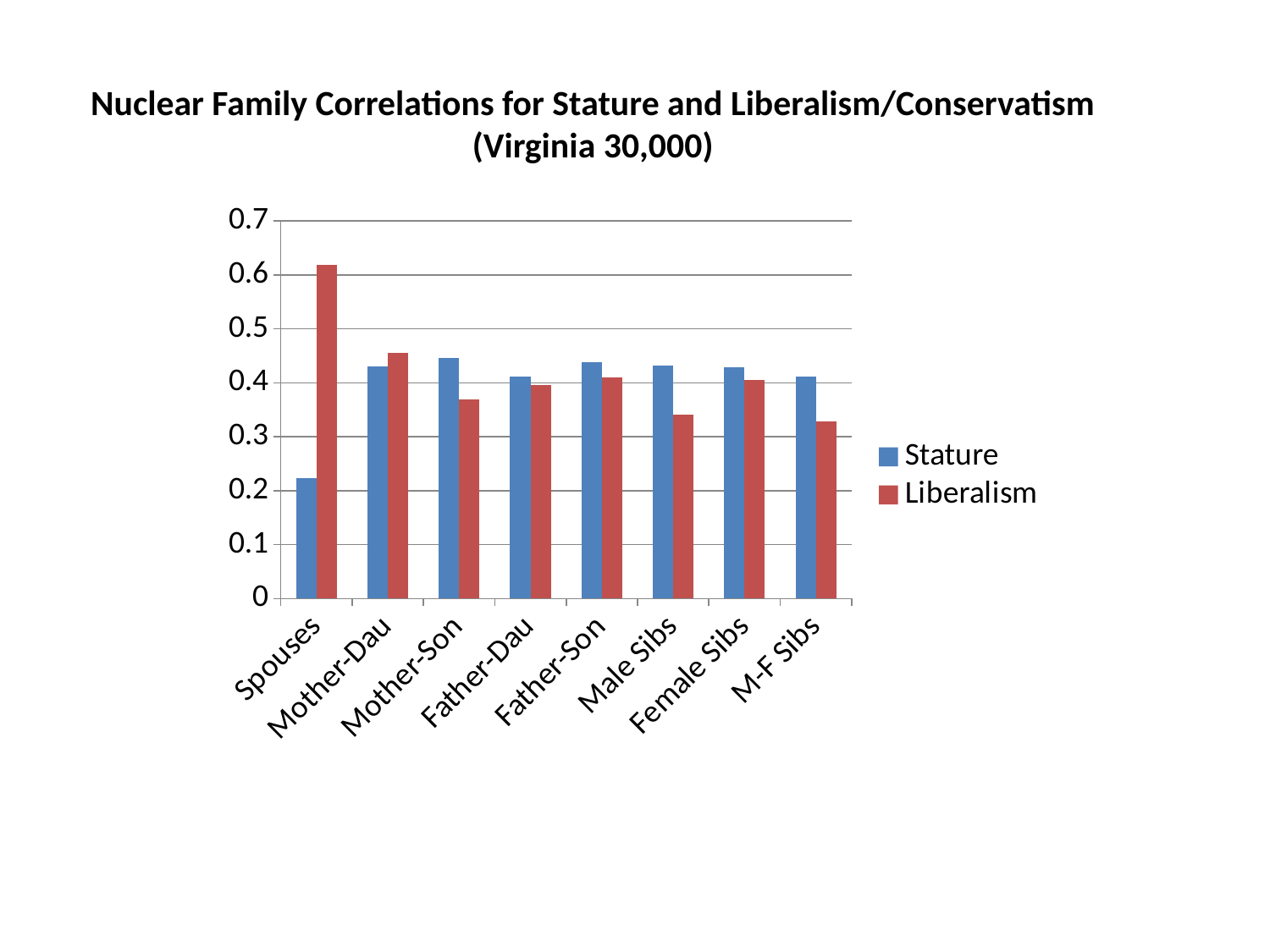
Is the Liberalism value for Male Sibs greater or less than 0.4? less For Mother-Son, which is larger, the Stature or the Liberalism correlation? Stature How many series does the legend list? 2 For Spouses, which is larger, the Stature or the Liberalism correlation? Liberalism Is the Stature value for Spouses greater or less than 0.3? less Which category has the lowest Stature correlation? Spouses Which category has the highest Liberalism correlation? Spouses How many family relationship categories are shown on the x axis? 8 Is the Liberalism value for Spouses greater or less than 0.6? greater What kind of chart is shown on the slide? bar chart For Male Sibs, which is larger, the Stature or the Liberalism correlation? Stature Which colour represents the Liberalism series in the legend? red